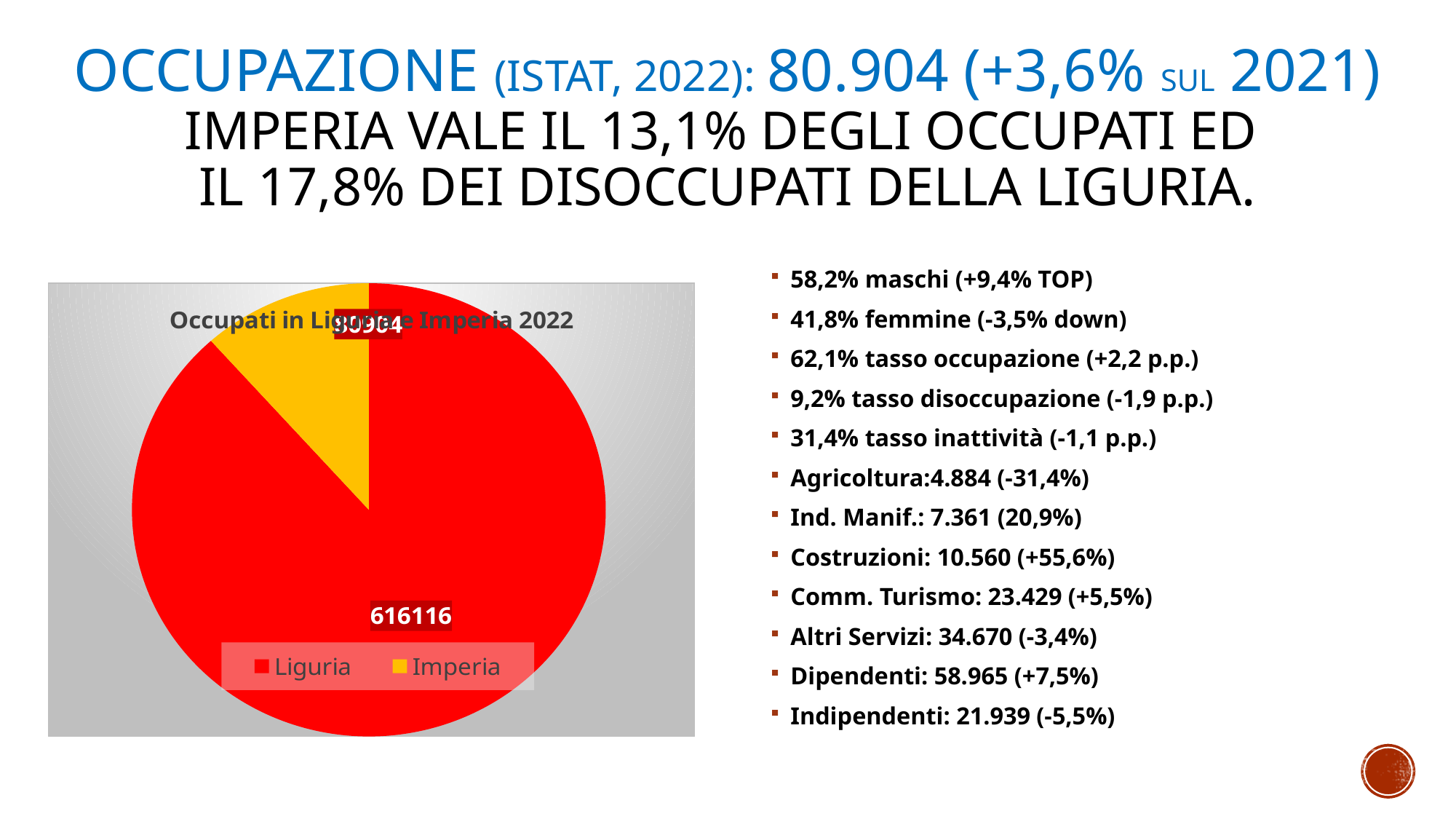
Which slice of the pie chart is the smallest? Imperia What is the value shown for Liguria in the pie chart? 616116 How many entries does the legend of the pie chart list? 2 Which slice of the pie chart is the largest? Liguria How many slices does the pie chart have? 2 What colour is the Imperia slice in the pie chart? yellow What kind of chart is shown on the slide? pie chart Which is larger in the pie chart, Liguria or Imperia? Liguria What is the title of the pie chart? Occupati in Liguria e Imperia 2022